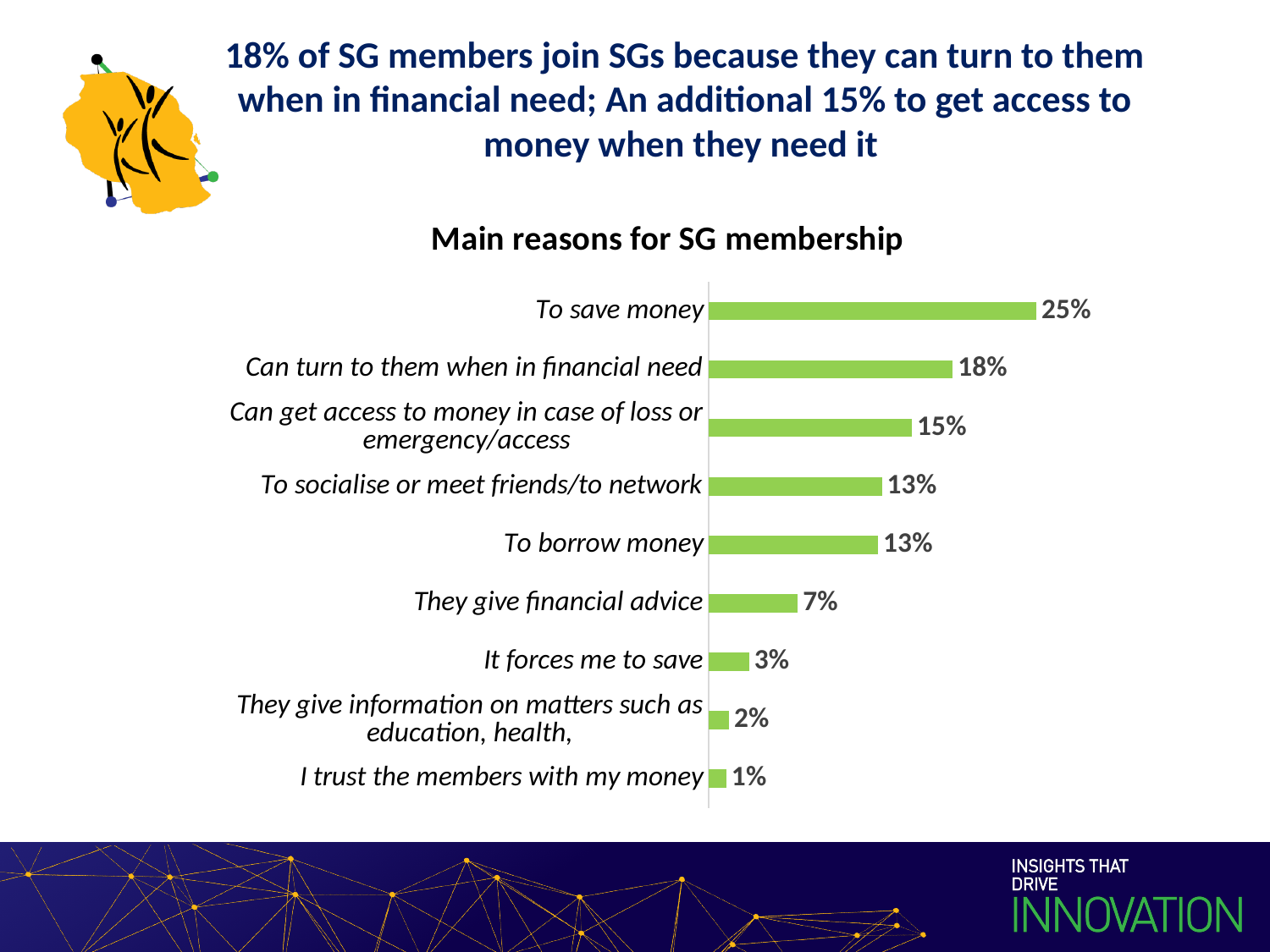
What is the value for 'To borrow money'? 13% Which reason has the lowest percentage? I trust the members with my money How many reasons (categories) are shown in the chart? 9 Which reason has the highest percentage? To save money What is the value for 'They give financial advice'? 7% What is the difference between 'To socialise or meet friends/to network' and 'They give financial advice'? 6% What kind of chart is shown on the slide? Bar chart What is the difference between 'To save money' and 'Can turn to them when in financial need'? 7% Which is larger: 'Can get access to money in case of loss or emergency/access' or 'They give financial advice'? Can get access to money in case of loss or emergency/access What is the value for 'It forces me to save'? 3% What percentage of SG members cite 'To save money' as a main reason for membership? 25% What is the title of the chart? Main reasons for SG membership